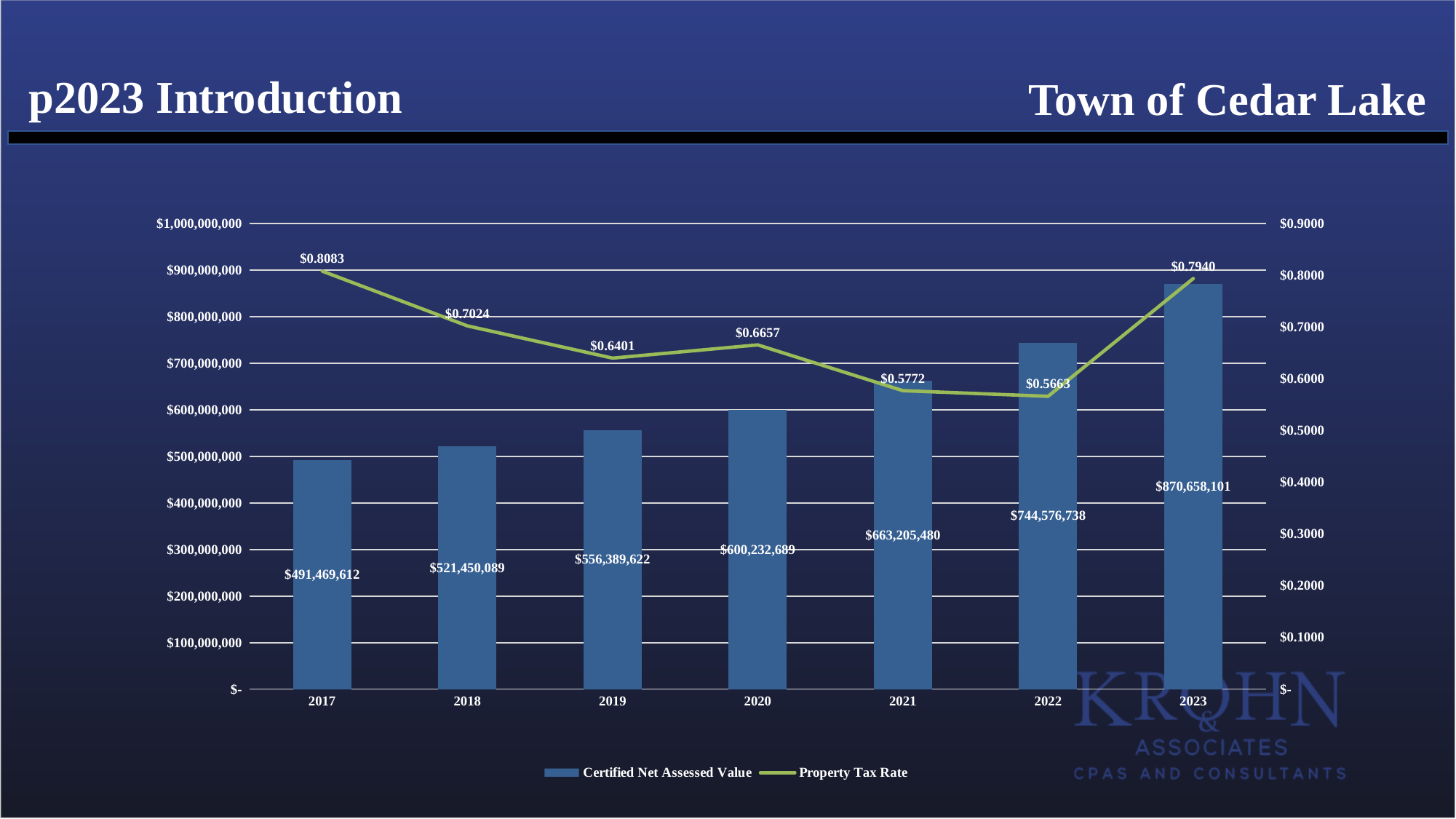
What is the Certified Net Assessed Value for 2020? $600,232,689 Is the Property Tax Rate higher in 2020 or in 2021? 2020 What is the Property Tax Rate for 2019? $0.6401 What is the difference between the Property Tax Rate in 2017 and in 2022? $0.2420 Which year has the highest Property Tax Rate? 2017 What is the Certified Net Assessed Value for 2023? $870,658,101 Which year has the highest Certified Net Assessed Value? 2023 How many series does the legend list? 2 How many years are shown on the x axis? 7 Does the Certified Net Assessed Value rise or fall from 2017 to 2023? rise What is the difference between the Certified Net Assessed Value in 2023 and in 2017? $379,188,489 Which year has the lowest Property Tax Rate? 2022